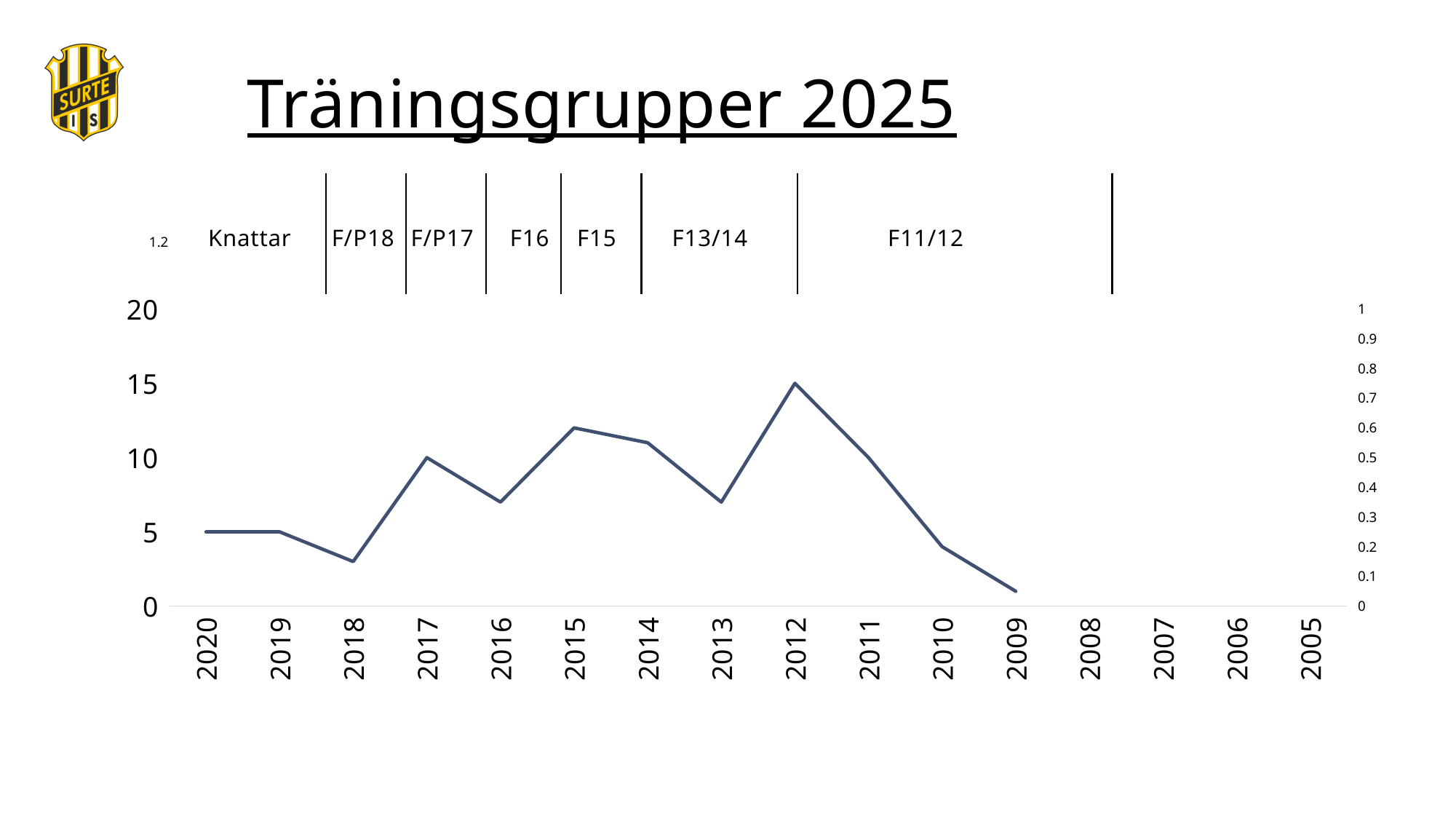
What is the value for 2017? 10 What is the value for 2012? 15 How many year labels are shown on the x axis? 16 Is the value for 2018 greater or less than 5? less Do the values rise or fall from 2012 to 2009? fall Is the value for 2010 greater or less than 5? less Which year has the highest value on the line? 2012 Is the value for 2015 greater or less than 10? greater Which is larger, the value for 2015 or the value for 2013? 2015 What is the title of the slide containing the chart? Träningsgrupper 2025 Which year has the lowest plotted value on the line? 2009 What kind of chart is shown on the slide? line chart